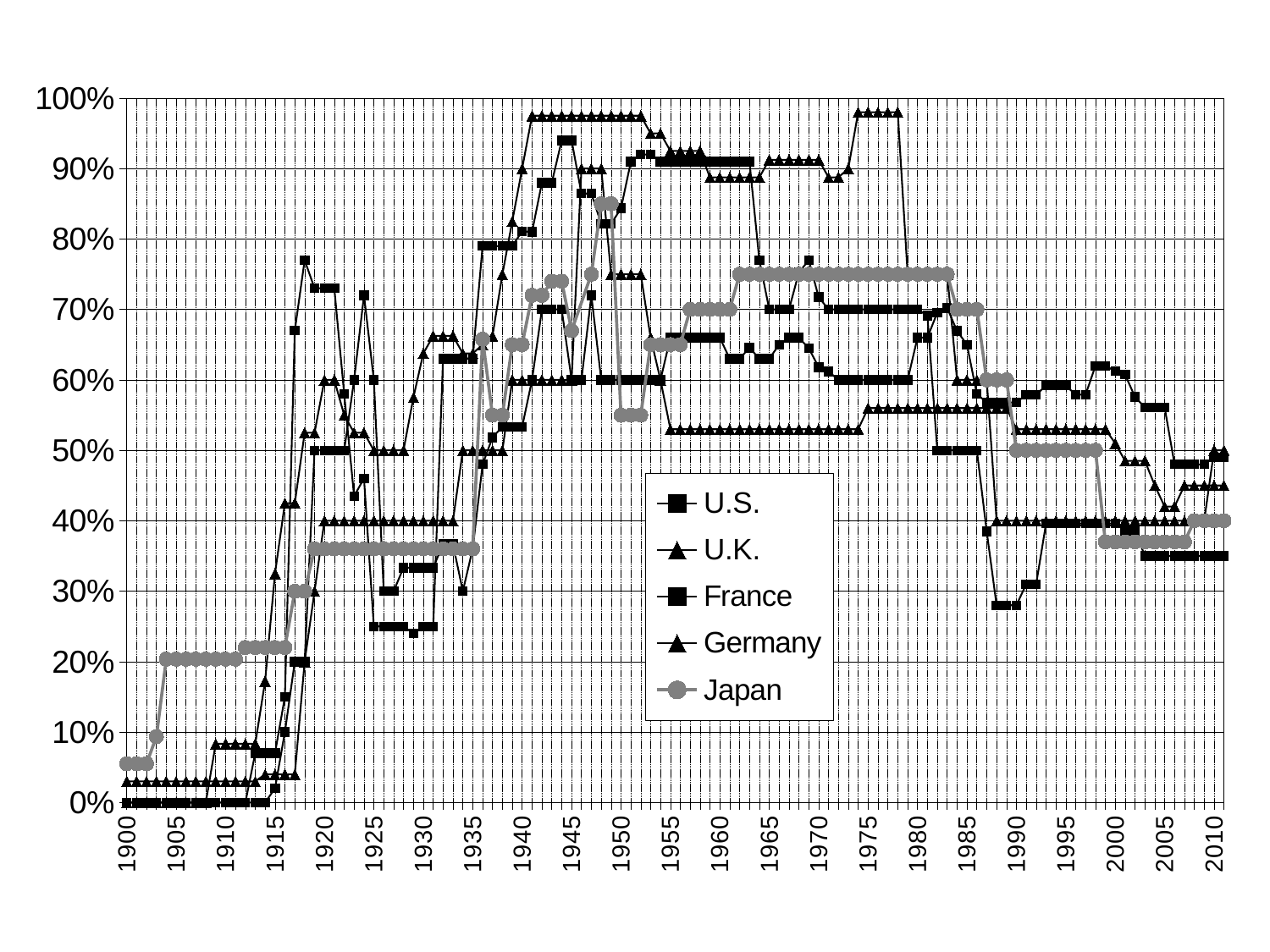
Is the value for Japan larger in 1950 or in 1900? 1950 Is the value for Japan in 1900 greater or less than 10%? less What kind of chart is shown on the slide? line chart Is the value for Japan in 1970 greater or less than 70%? greater Which series is drawn with gray circle markers? Japan Is the value for Japan in 2003 greater or less than 40%? less How many series does the legend list? 5 Which countries are listed in the legend? U.S., U.K., France, Germany, Japan Does the Japan series rise or fall between 1900 and 1950? rise